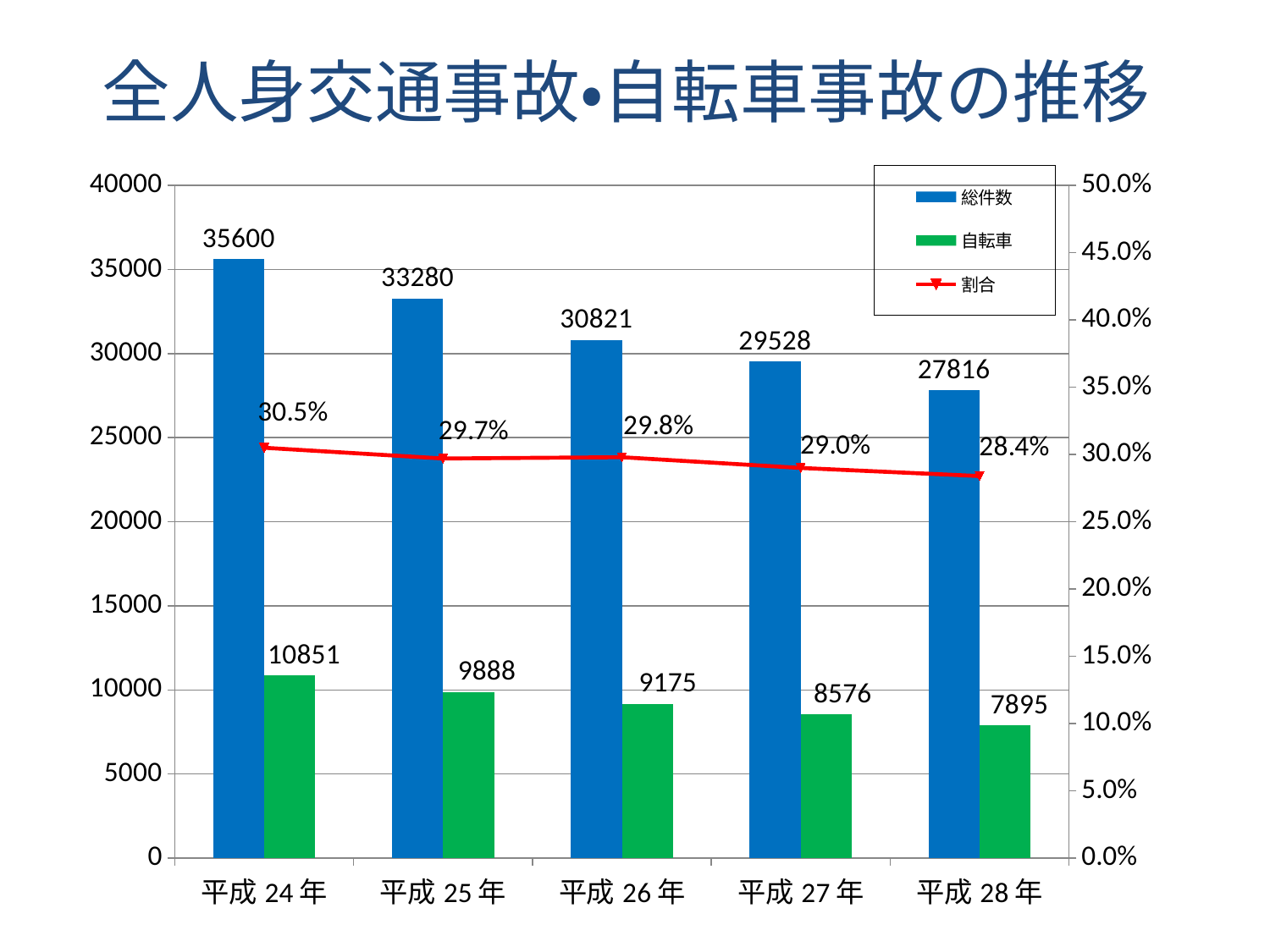
Which is larger, the 割合 value for 平成 25 年 or for 平成 26 年? 平成 26 年 What is the title of the chart? 全人身交通事故•自転車事故の推移 How many years are shown on the x axis? 5 What is the value of 自転車 for 平成 27 年? 8576 How many series does the legend list? 3 What is the difference between the 自転車 values for 平成 26 年 and 平成 28 年? 1280 Which year has the highest 自転車 value? 平成 24 年 Does the 総件数 series rise or fall from 平成 24 年 to 平成 28 年? fall What is the value of 総件数 for 平成 24 年? 35600 What is the difference between the 総件数 values for 平成 24 年 and 平成 25 年? 2320 Which year has the lowest 総件数 value? 平成 28 年 What is the 割合 value for 平成 26 年? 29.8%